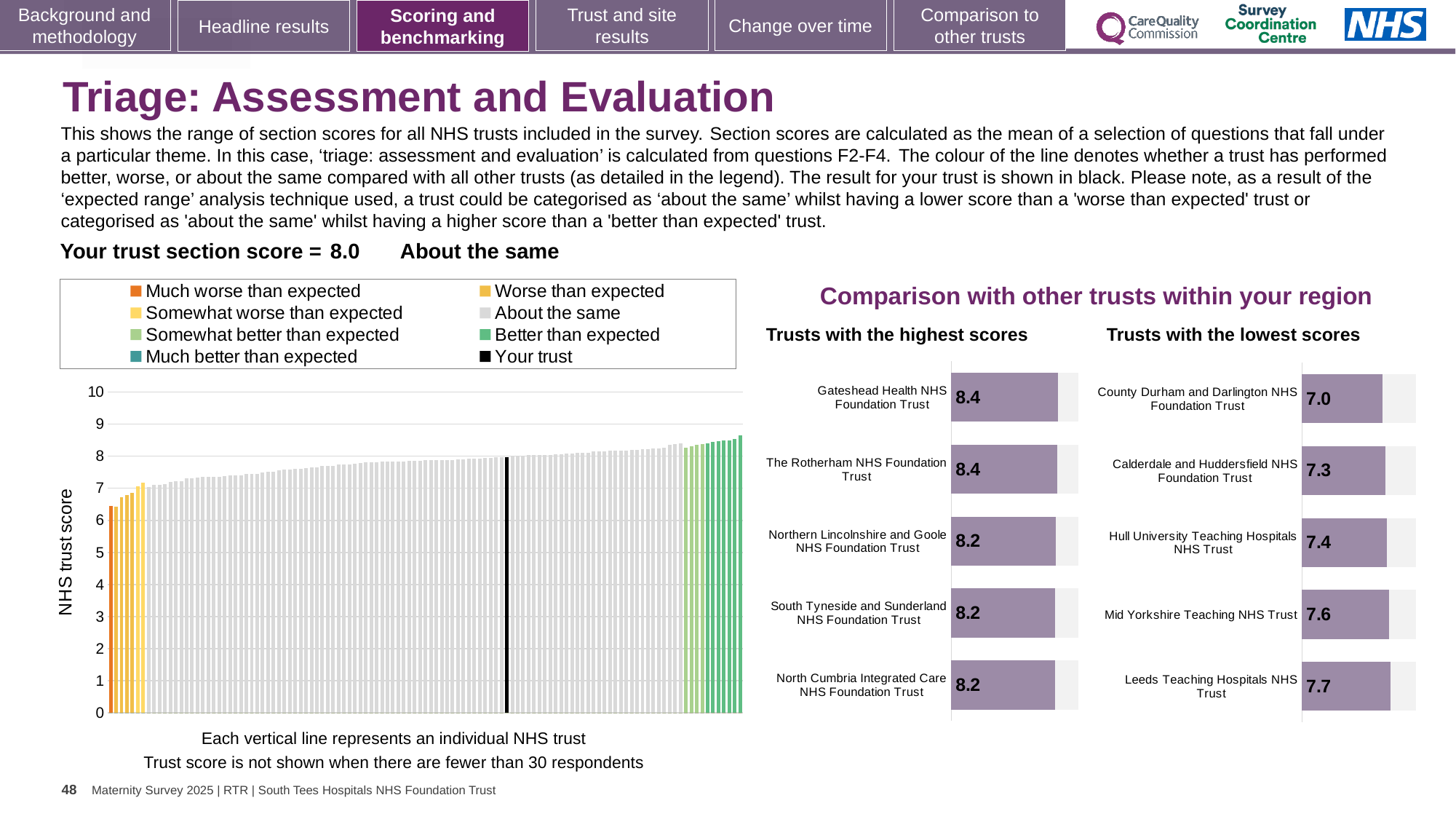
In the 'Trusts with the lowest scores' chart, which has the larger score: Calderdale and Huddersfield NHS Foundation Trust or Mid Yorkshire Teaching NHS Trust? Mid Yorkshire Teaching NHS Trust How many entries does the legend of the large chart on the left list? 8 In the 'Trusts with the lowest scores' chart, what is the score for Hull University Teaching Hospitals NHS Trust? 7.4 In the 'Trusts with the highest scores' chart, what is the difference between the scores of Gateshead Health NHS Foundation Trust and North Cumbria Integrated Care NHS Foundation Trust? 0.2 In the 'Trusts with the lowest scores' chart, what is the difference between the scores of Leeds Teaching Hospitals NHS Trust and County Durham and Darlington NHS Foundation Trust? 0.7 In the large chart on the left, is the value of the lowest (leftmost) bar greater or less than 7? less In the 'Trusts with the highest scores' chart, what is the score for Gateshead Health NHS Foundation Trust? 8.4 In the 'Trusts with the lowest scores' chart, which trust has the lowest score? County Durham and Darlington NHS Foundation Trust In the 'Trusts with the lowest scores' chart, which trust has the highest score? Leeds Teaching Hospitals NHS Trust How many trusts are listed in the 'Trusts with the highest scores' chart? 5 What kind of chart is the large chart on the left showing NHS trust scores? Bar chart In the large chart on the left, is the value of the highest (rightmost) bar greater or less than 8? greater